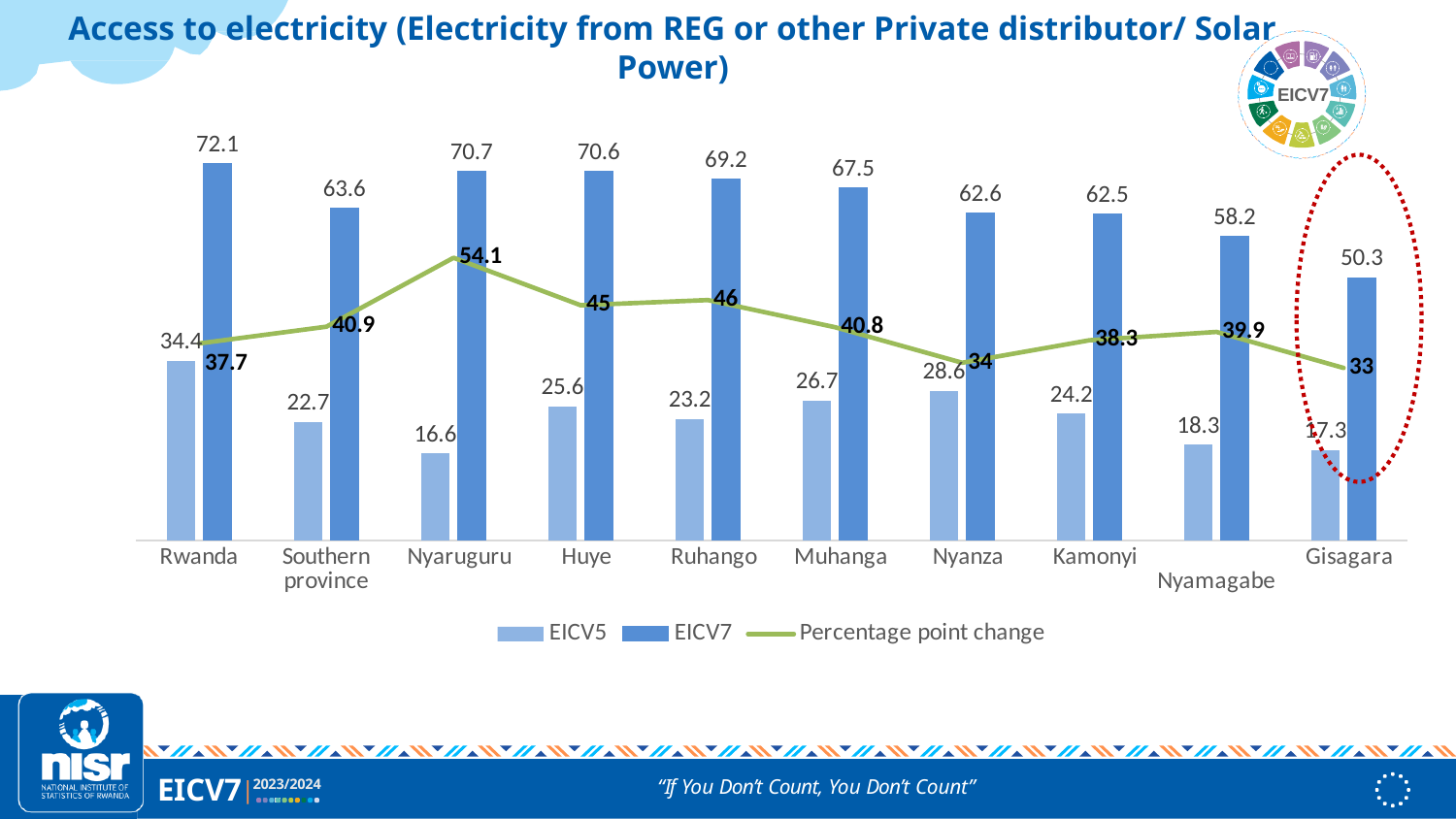
Which category has the lowest EICV5 value? Nyaruguru Which category has the highest EICV7 value? Rwanda How many series does the legend list? 3 Which category has the largest percentage point change? Nyaruguru What is the difference between the EICV7 values for Rwanda and Gisagara? 21.8 How many categories are shown on the x axis? 10 Which has the larger EICV5 value, Huye or Muhanga? Muhanga What is the EICV7 value for Nyaruguru? 70.7 What is the percentage point change shown for Huye? 45 What is the EICV5 value for Nyanza? 28.6 Which category has the lowest EICV7 value? Gisagara Which category is circled with a red dotted line on the chart? Gisagara